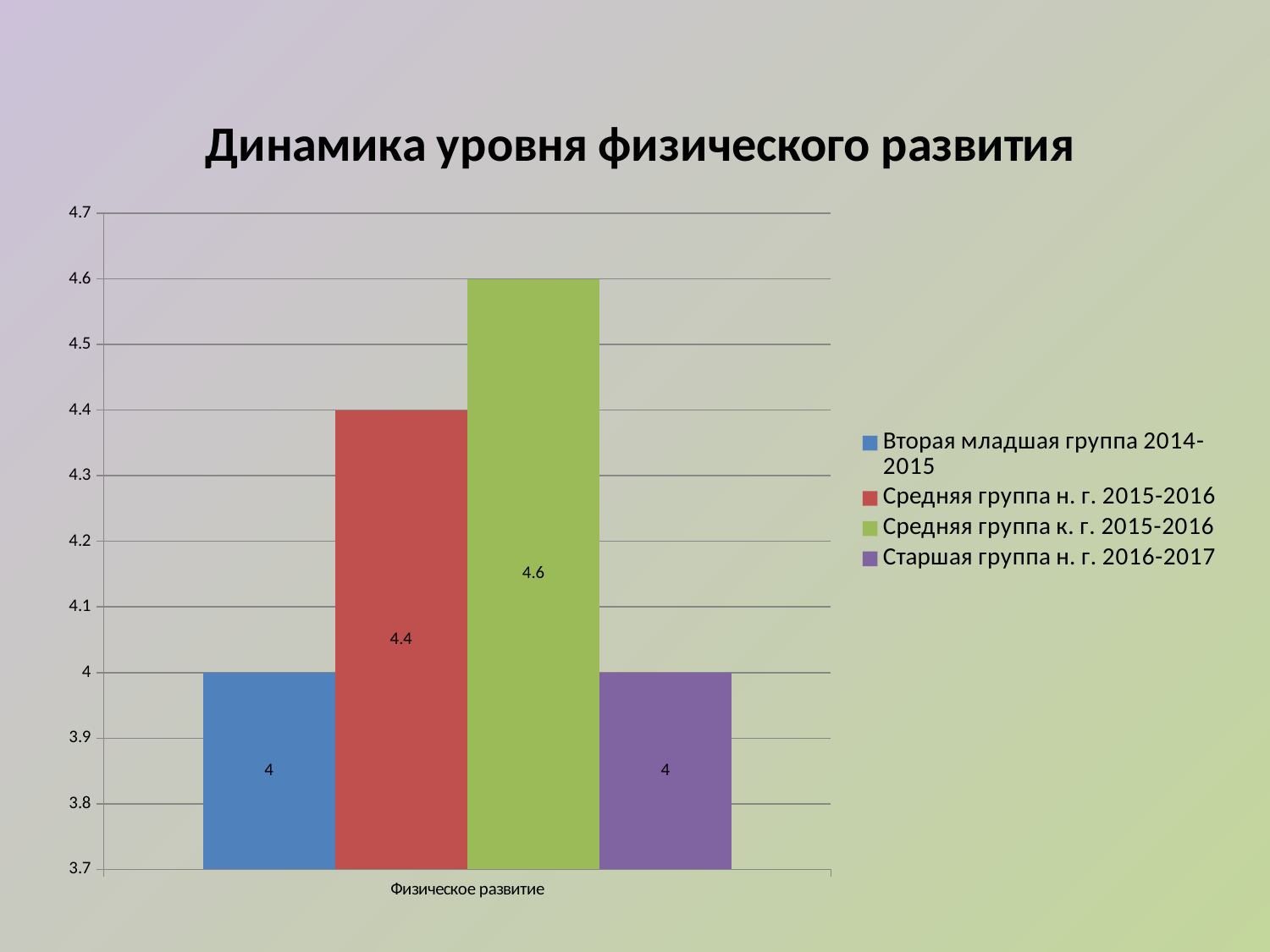
Which is larger, the value for Средняя группа н. г. 2015-2016 or the value for Старшая группа н. г. 2016-2017? Средняя группа н. г. 2015-2016 What is the value for Средняя группа к. г. 2015-2016? 4.6 What is the value for Старшая группа н. г. 2016-2017? 4 How many series does the legend list? 4 What is the title of the chart? Динамика уровня физического развития What is the value for Средняя группа н. г. 2015-2016? 4.4 What kind of chart is shown on the slide? bar chart What is the difference between the values for Средняя группа н. г. 2015-2016 and Вторая младшая группа 2014-2015? 0.4 Which series has the highest value? Средняя группа к. г. 2015-2016 What is the value for Вторая младшая группа 2014-2015? 4 What is the difference between the values for Средняя группа к. г. 2015-2016 and Средняя группа н. г. 2015-2016? 0.2 Is the value for Средняя группа к. г. 2015-2016 greater or less than 4.5? greater